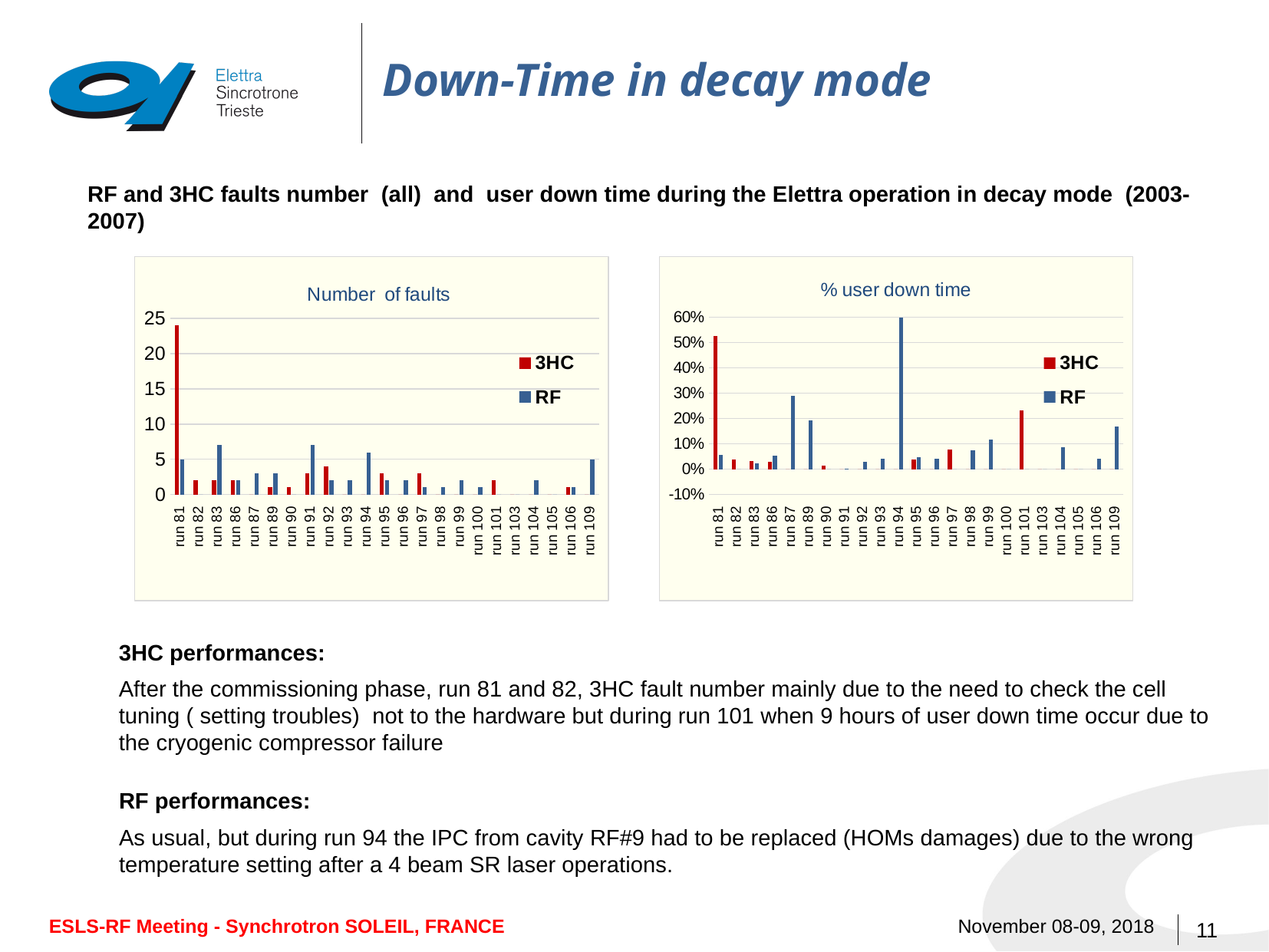
How many series does the legend of the "% user down time" chart list? 2 What is the title of the chart on the right of the slide? % user down time In the "% user down time" chart, is the RF value for run 94 greater or less than 50%? greater What kind of chart is the "Number of faults" chart? bar chart In the "% user down time" chart, is the 3HC value for run 81 greater or less than 50%? greater In the "Number of faults" chart, which series has the larger value for run 83, 3HC or RF? RF In the "Number of faults" chart, is the 3HC value for run 81 greater or less than 20? greater How many runs are shown on the x axis of the "Number of faults" chart? 23 In the "% user down time" chart, which run has the highest RF user down time? run 94 What are the two legend entries in the "Number of faults" chart? 3HC and RF In the "Number of faults" chart, which run has the highest number of 3HC faults? run 81